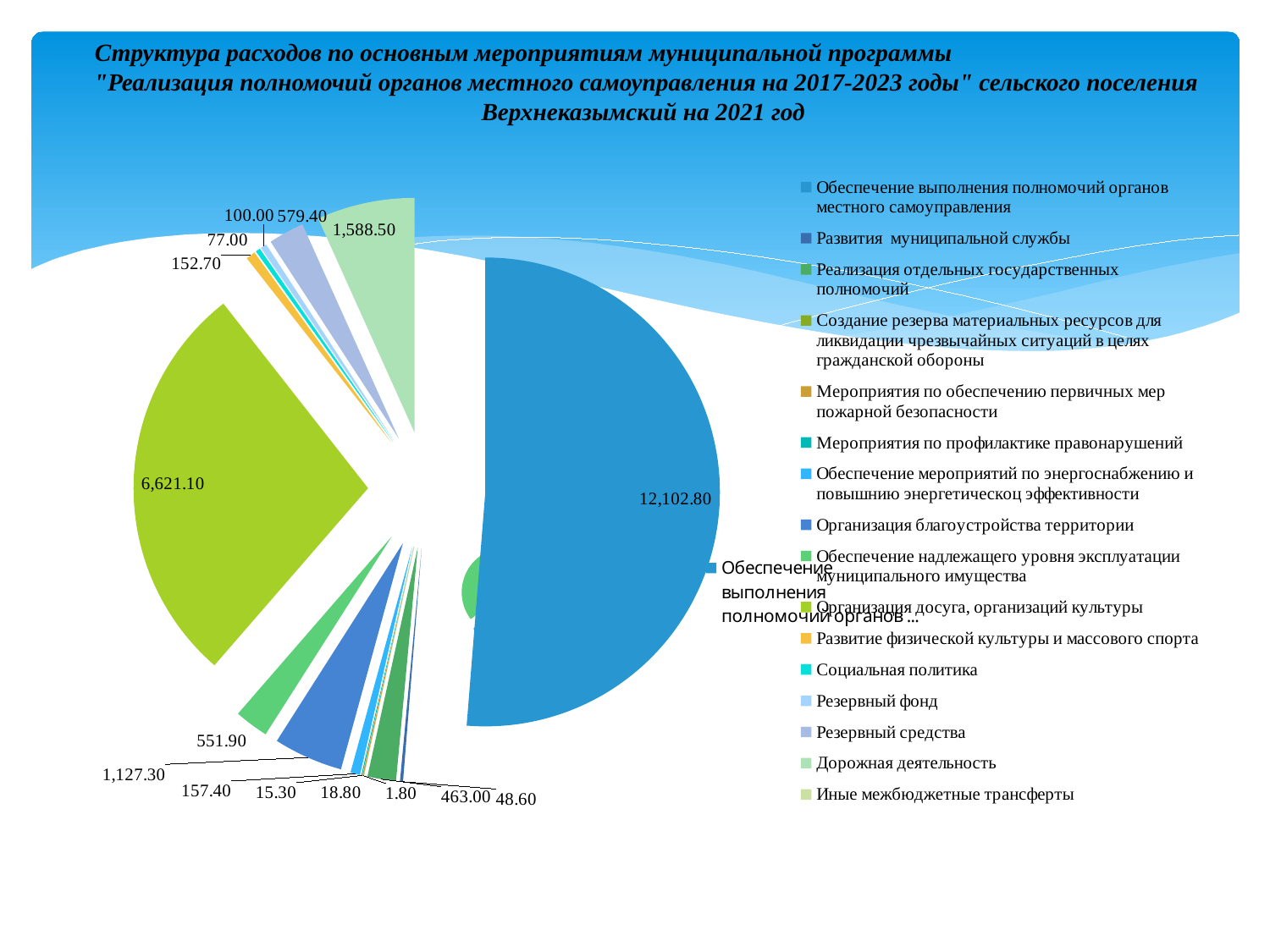
What is the second-largest value labelled on the pie chart? 6,621.10 For which year does the chart title say the expenditure structure is shown? 2021 What is the difference between the two largest labelled slices, 12,102.80 and 6,621.10? 5,481.70 What is the difference between the slices labelled 1,588.50 and 1,127.30? 461.20 How many categories does the legend of the pie chart list? 16 Which labelled slice is larger: the one with 157.40 or the one with 152.70? 157.40 What is the largest value labelled on the pie chart? 12,102.80 What is the difference between the slices labelled 551.90 and 463.00? 88.90 What is the smallest value labelled on the pie chart? 1.80 Which labelled slice is larger: the one with 1,588.50 or the one with 1,127.30? 1,588.50 What value is shown for the slice 'Обеспечение выполнения полномочий органов местного самоуправления'? 12,102.80 What kind of chart is shown on the slide? pie chart